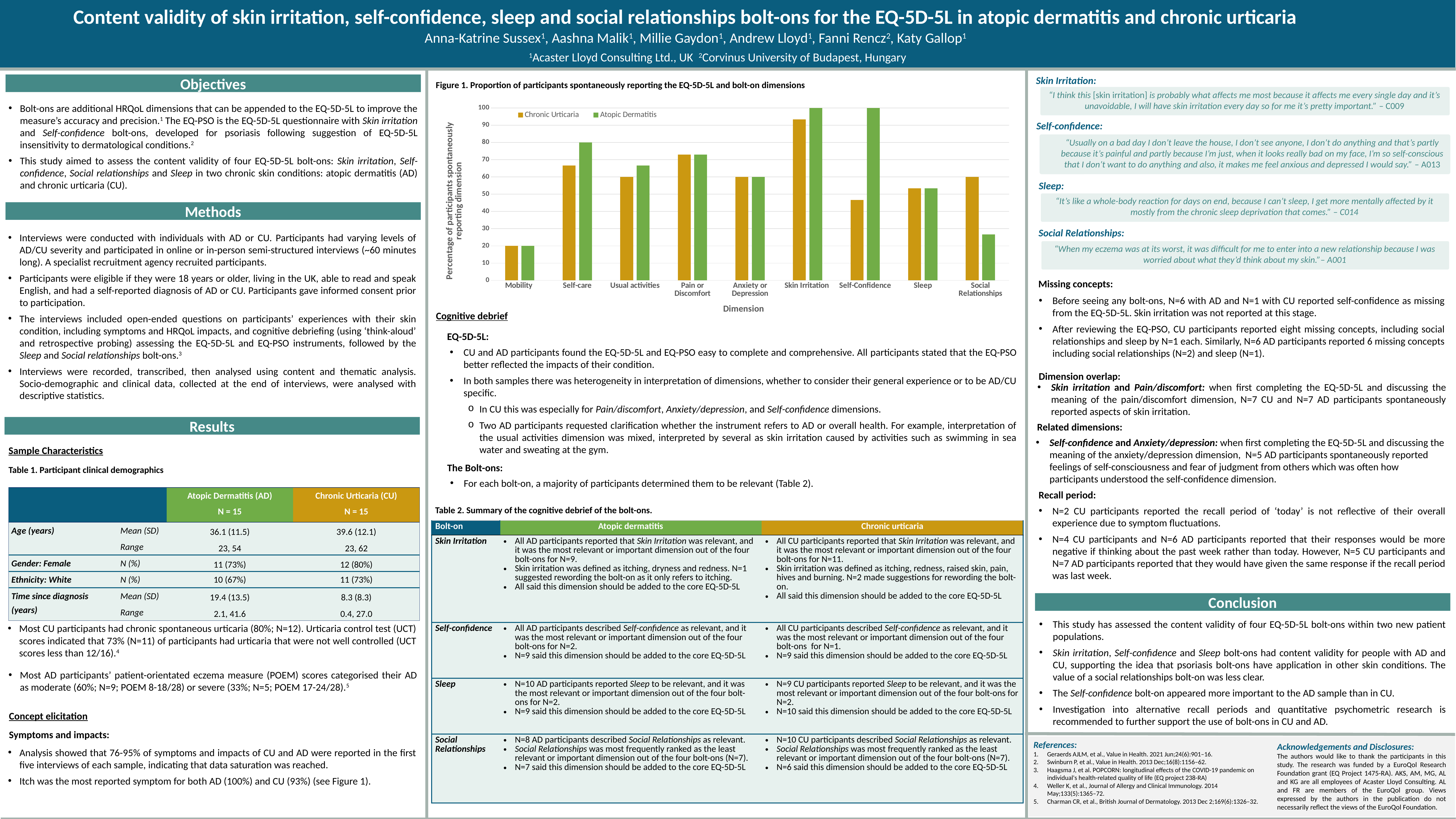
In Figure 1, is the Atopic Dermatitis value for Social Relationships greater or less than 30? less How many dimensions are shown on the x axis of Figure 1? 9 In Figure 1, for Social Relationships, which group has the larger value: Chronic Urticaria or Atopic Dermatitis? Chronic Urticaria How many series does the legend of Figure 1 list? 2 In Figure 1, is the Atopic Dermatitis value for Self-care greater or less than 70? greater In Figure 1, which dimension has the lowest value for Chronic Urticaria? Mobility In Figure 1, is the Chronic Urticaria value for Skin Irritation greater or less than 90? greater In Figure 1, which dimension has the highest value for Chronic Urticaria? Skin Irritation In Figure 1, for Self-Confidence, which group has the larger value: Chronic Urticaria or Atopic Dermatitis? Atopic Dermatitis What are the two legend entries in Figure 1? Chronic Urticaria and Atopic Dermatitis What kind of chart is Figure 1? bar chart